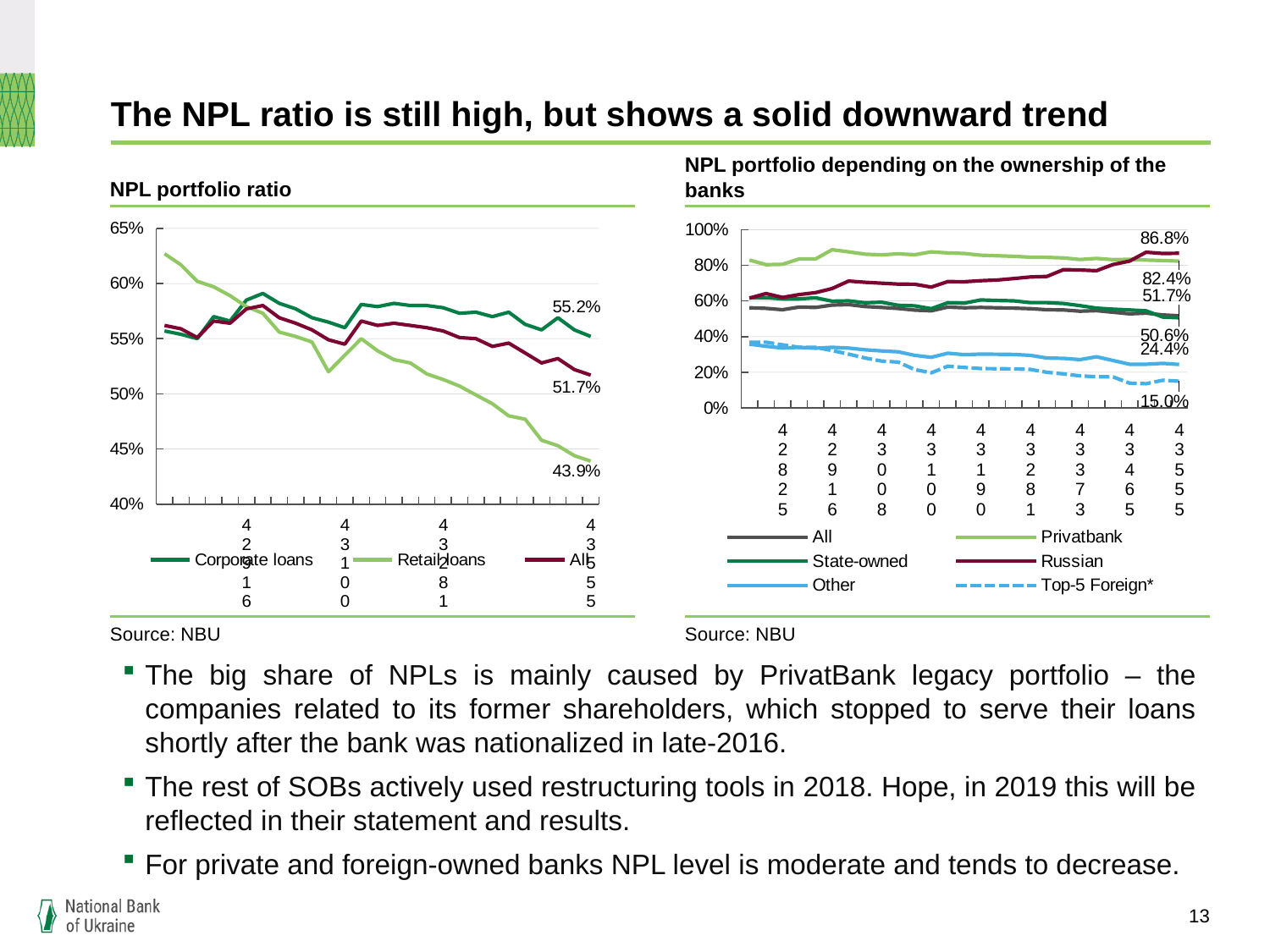
What kind of chart is the 'NPL portfolio ratio' chart? Line chart In the 'NPL portfolio ratio' chart, what is the final labelled value for Retail loans? 43.9% In the 'NPL portfolio ratio' chart, what is the final labelled value for All loans? 51.7% In the 'NPL portfolio depending on the ownership of the banks' chart, which series is drawn with a dashed line? Top-5 Foreign* In the 'NPL portfolio ratio' chart, what is the difference between the final labelled values for Corporate loans and Retail loans? 11.3 percentage points In the 'NPL portfolio ratio' chart, does the Retail loans line rise or fall over the period shown? Fall In the 'NPL portfolio depending on the ownership of the banks' chart, what is the final labelled value for Top-5 Foreign*? 15.0% In the 'NPL portfolio ratio' chart, what is the final labelled value for Corporate loans? 55.2% In the 'NPL portfolio depending on the ownership of the banks' chart, is the value for Privatbank at the start of the period greater or less than 60%? greater In the 'NPL portfolio depending on the ownership of the banks' chart, what is the final labelled value for Other? 24.4% How many series does the legend of the 'NPL portfolio ratio' chart list? 3 How many series does the legend of the 'NPL portfolio depending on the ownership of the banks' chart list? 6